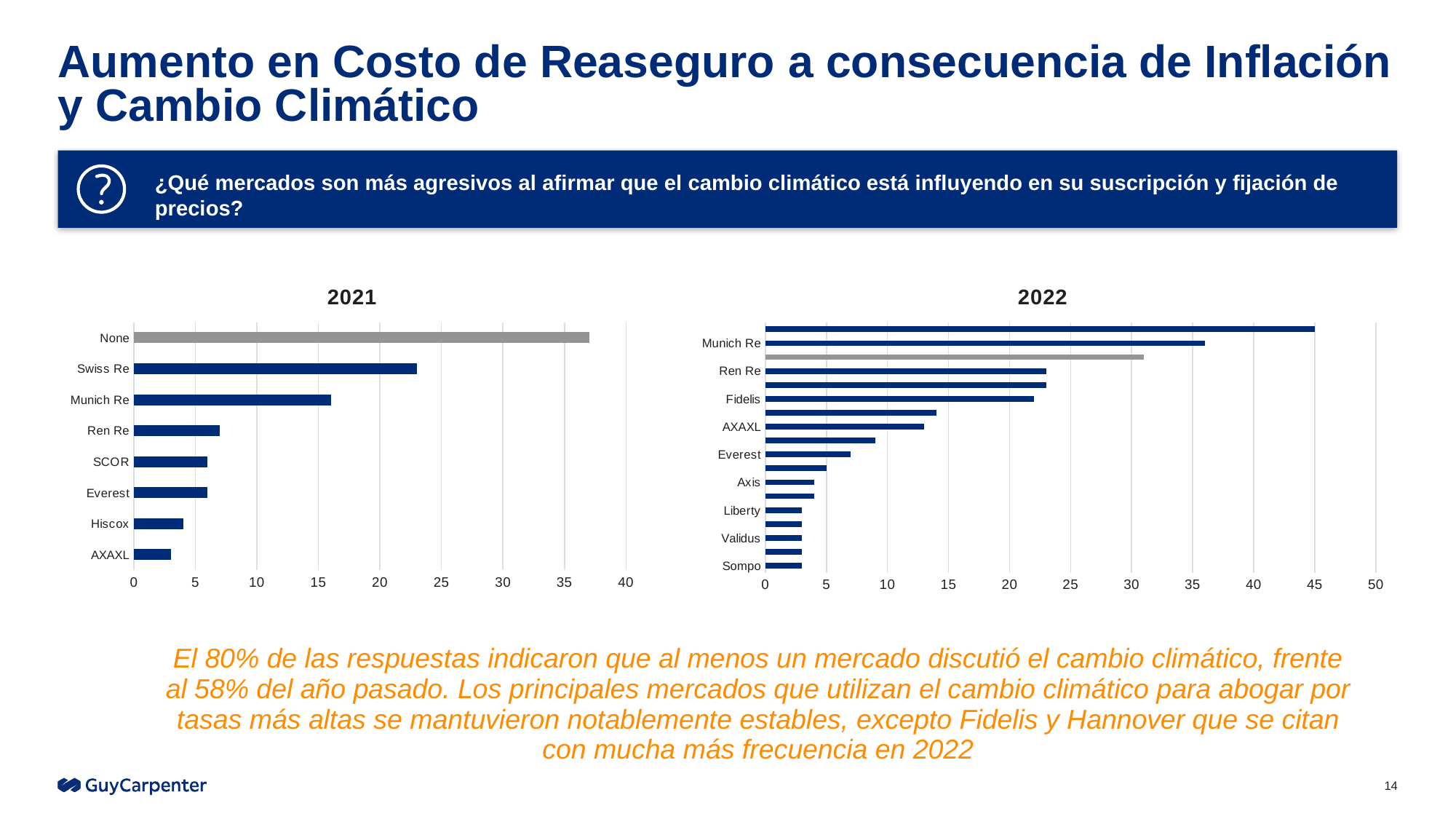
In the 2021 chart, which has the larger value, Swiss Re or Munich Re? Swiss Re In the 2021 chart, which category has the longest bar? None In the 2021 chart, which has the larger value, Hiscox or AXAXL? Hiscox In the 2022 chart, is the longest bar greater or less than 40? greater How many categories are shown in the 2021 chart? 8 In the 2021 chart, is the value for Munich Re greater or less than 20? less In the 2021 chart, do the bar lengths increase or decrease going from the top category to the bottom category? decrease In the 2021 chart, is the value for None greater or less than 35? greater In the 2021 chart, which category has the shortest bar? AXAXL In the 2021 chart, which category is drawn with a gray bar instead of a blue one? None What kind of chart is the 2021 chart? bar chart